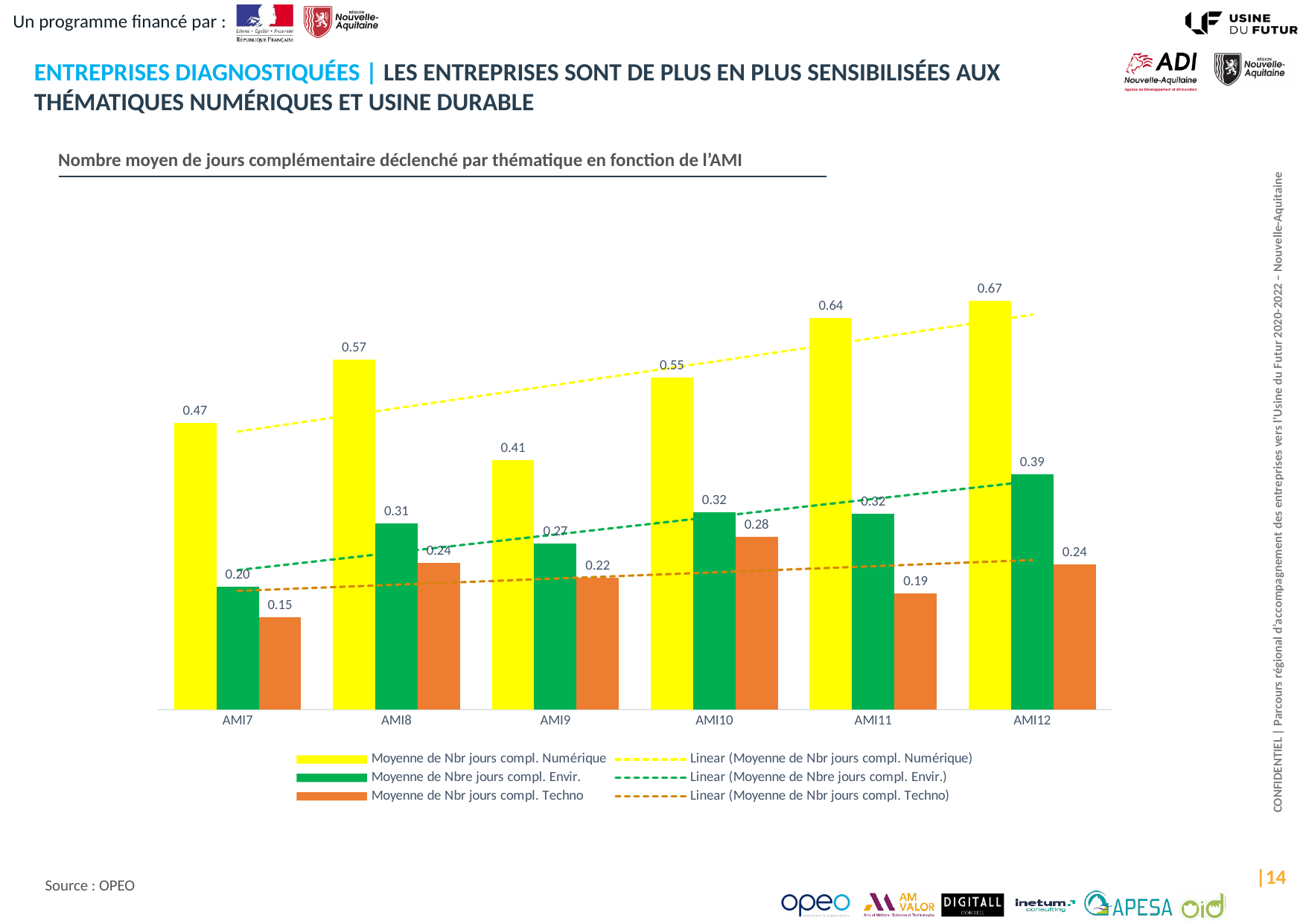
Which is larger, the Techno value for AMI10 or the Techno value for AMI11? AMI10 How many AMI categories are shown on the x axis? 6 What is the value of Moyenne de Nbr jours compl. Techno for AMI7? 0.15 What colour are the bars for Moyenne de Nbr jours compl. Numérique? Yellow What is the difference between the Numérique values for AMI12 and AMI7? 0.20 Which AMI has the lowest value for Moyenne de Nbr jours compl. Techno? AMI7 What is the value of Moyenne de Nbre jours compl. Envir. for AMI8? 0.31 How many entries does the legend list? 6 Which AMI has the highest value for Moyenne de Nbr jours compl. Numérique? AMI12 Does the Moyenne de Nbre jours compl. Envir. value rise or fall from AMI11 to AMI12? Rise What is the value of Moyenne de Nbr jours compl. Numérique for AMI12? 0.67 What kind of chart is shown on the slide? Bar chart